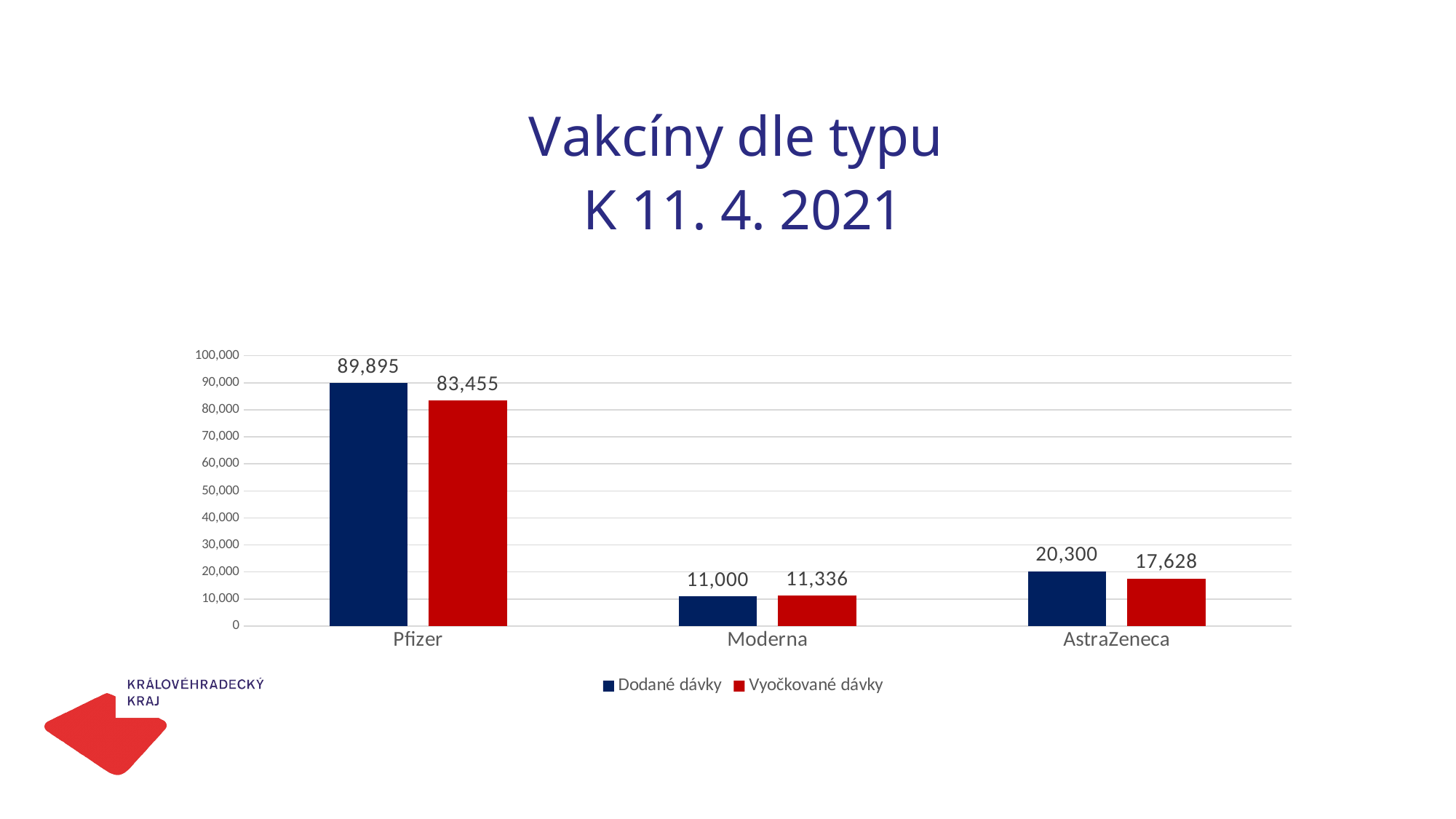
What is the value of Dodané dávky for Pfizer? 89,895 What is the difference between Dodané dávky and Vyočkované dávky for AstraZeneca? 2,672 How many categories are shown on the x axis? 3 For Moderna, which is larger: Dodané dávky or Vyočkované dávky? Vyočkované dávky What is the difference between Dodané dávky and Vyočkované dávky for Pfizer? 6,440 What kind of chart is shown on the slide? Bar chart Which category has the highest value for Dodané dávky? Pfizer What is the value of Vyočkované dávky for AstraZeneca? 17,628 What is the value of Vyočkované dávky for Moderna? 11,336 How many series does the legend list? 2 Which category has the lowest value for Vyočkované dávky? Moderna What is the title of the slide? Vakcíny dle typu K 11. 4. 2021